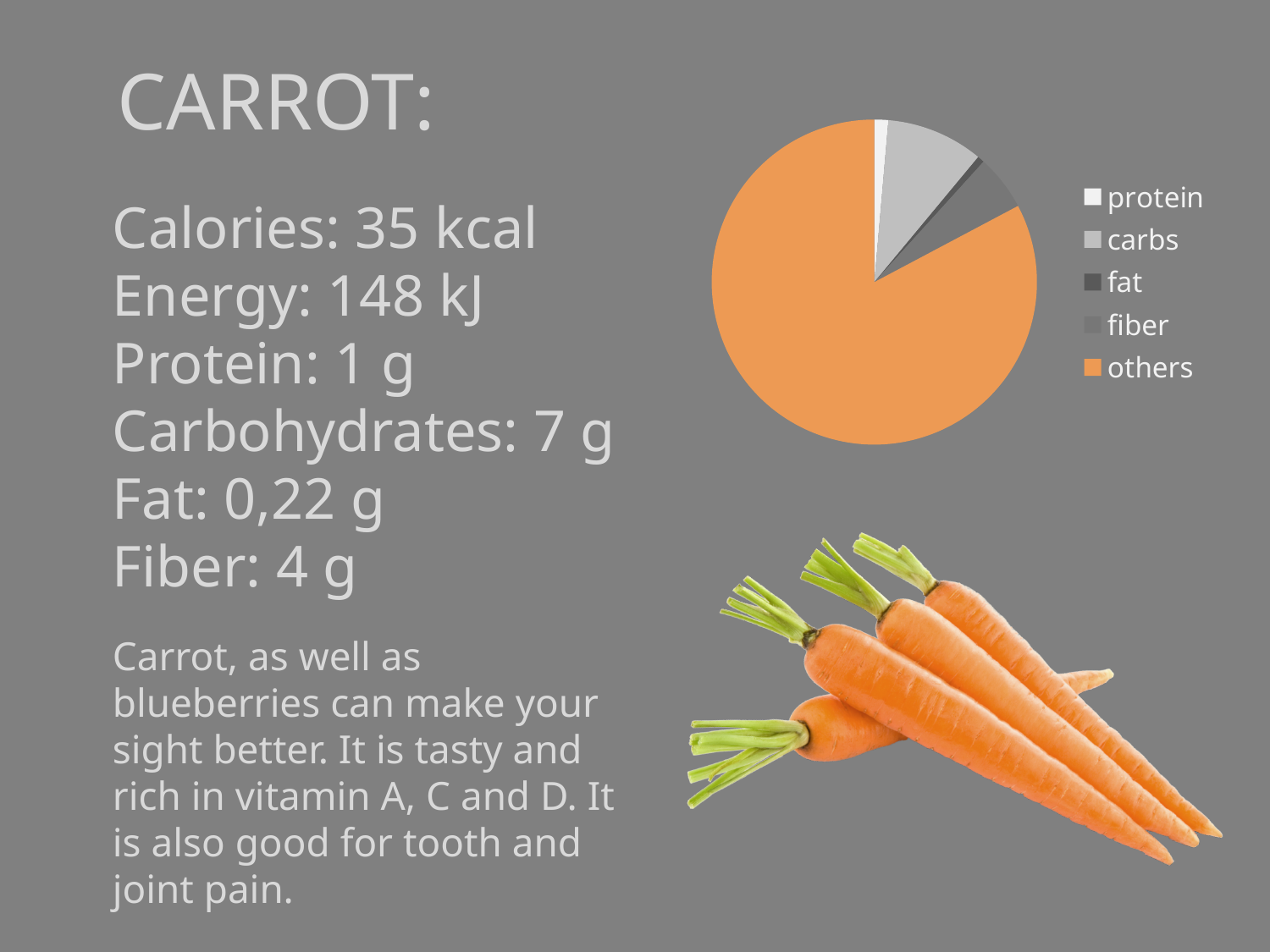
Which category is listed first in the pie chart's legend? protein What colour is the 'others' slice in the pie chart? orange Which slice is larger in the pie chart, carbs or protein? carbs Which slice is larger in the pie chart, others or carbs? others How many entries does the legend of the pie chart list? 5 Which category has the largest slice in the pie chart? others How many slices does the pie chart have? 5 What kind of chart is shown on the slide? pie chart